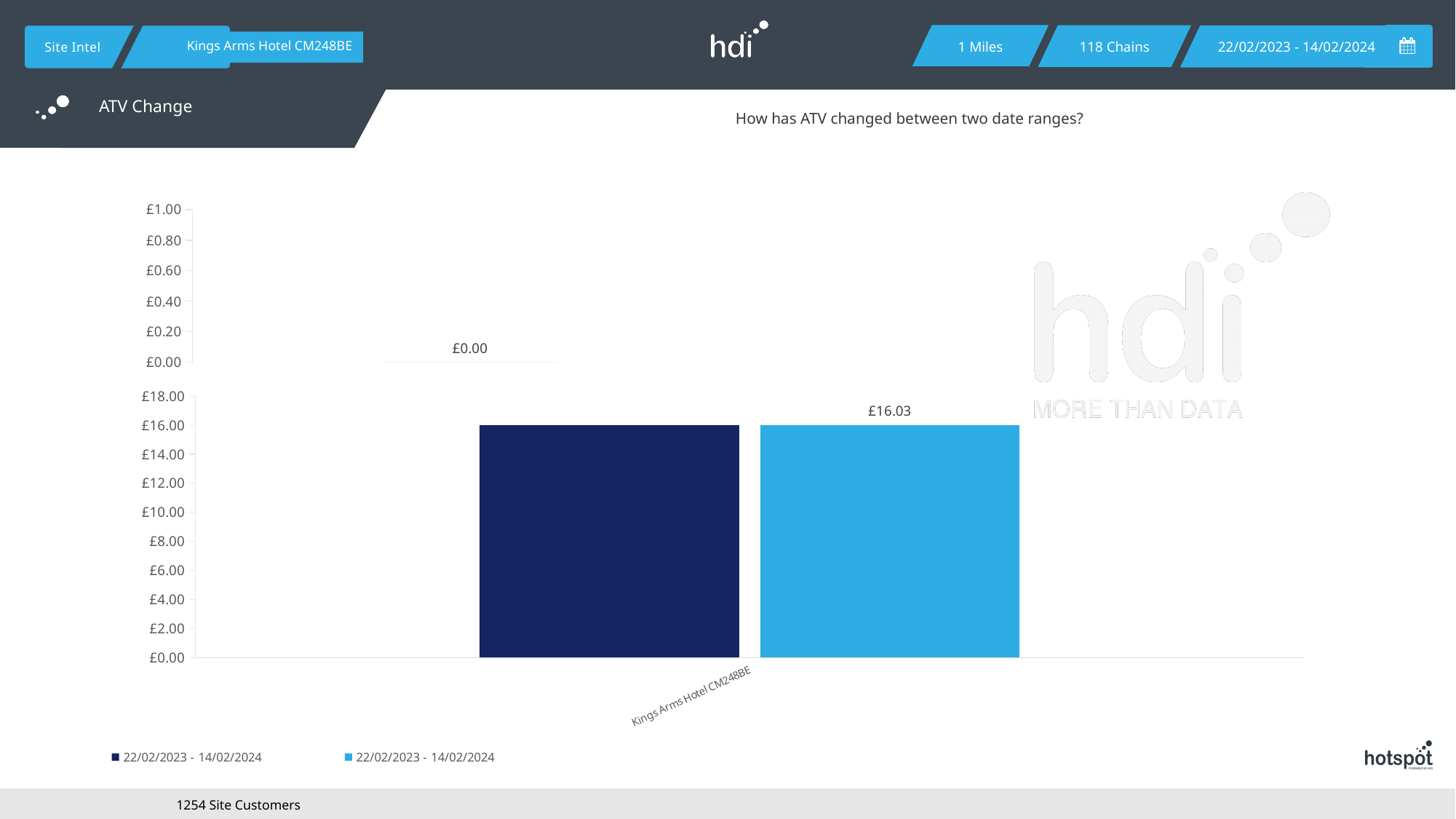
In the bottom chart, what is the value of the light blue bar for Kings Arms Hotel CM248BE? £16.03 What is the highest tick on the y axis of the bottom chart? £18.00 What is the highest tick on the y axis of the top chart? £1.00 In the bottom chart, is the value of the light blue bar greater or less than £10.00? greater What kind of chart is the bottom chart? bar chart How many categories are shown on the x axis of the bottom chart? 1 What date range is shown for the dark blue series in the legend? 22/02/2023 - 14/02/2024 In the bottom chart, is the value of the dark blue bar greater or less than £14.00? greater In the top chart, what value is printed above the bar? £0.00 How many series does the legend of the bottom chart list? 2 What question is written as the heading above the charts? How has ATV changed between two date ranges? In the bottom chart, is the value of the dark blue bar greater or less than £18.00? less